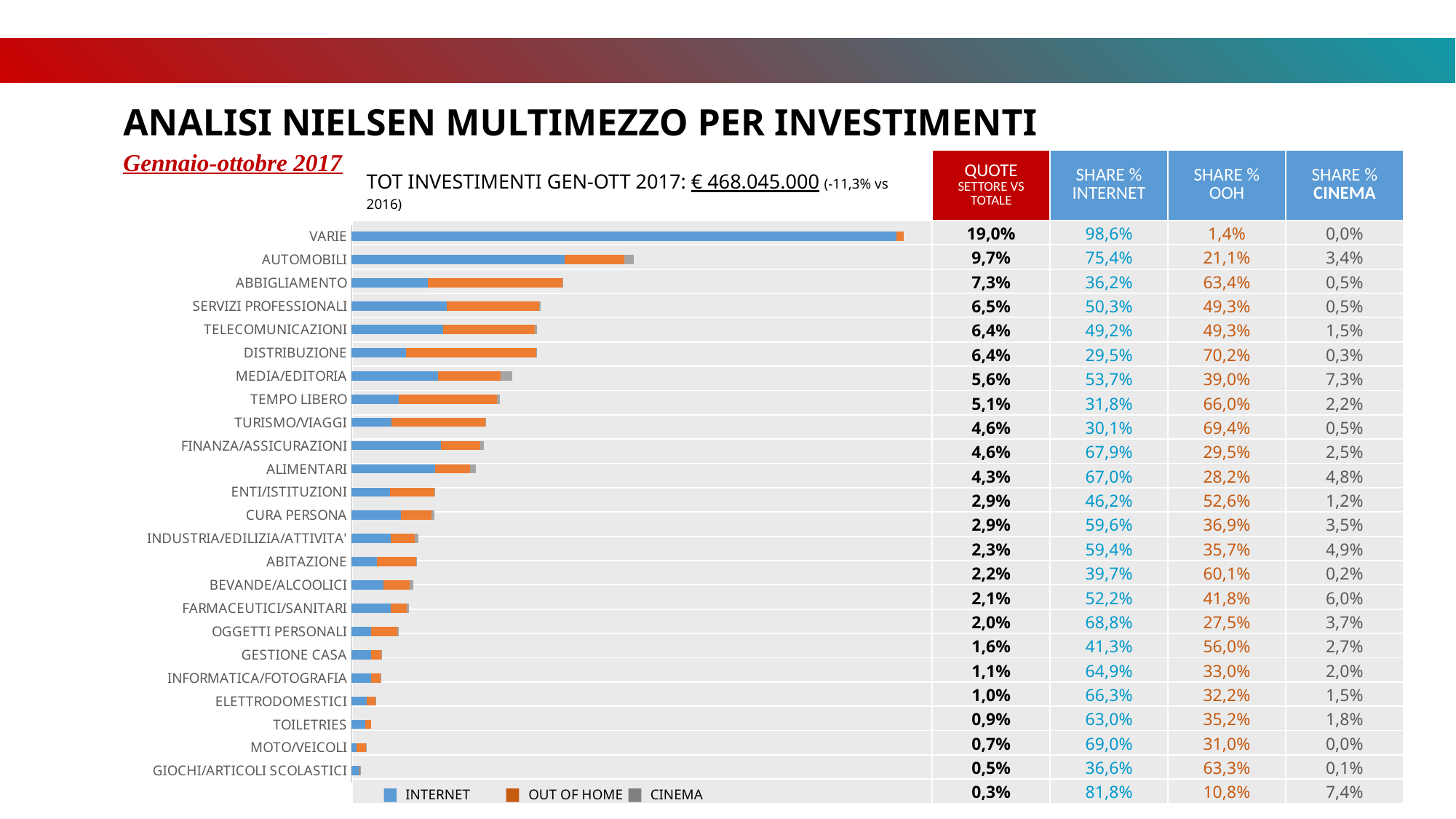
Which category has the longest bar in the chart? VARIE Which colour represents the CINEMA series in the chart? grey In the ABBIGLIAMENTO bar, which segment is larger, INTERNET or OUT OF HOME? OUT OF HOME What are the three series named in the chart legend? INTERNET, OUT OF HOME, CINEMA In the VARIE bar, which series makes up almost the entire bar? INTERNET Which category has the shortest bar in the chart? GIOCHI/ARTICOLI SCOLASTICI Do the bar lengths increase or decrease going from the top category to the bottom category? decrease How many series does the chart legend list? 3 How many categories (sectors) are plotted in the chart? 24 What kind of chart is shown on the slide? stacked bar chart Which bar is longer, TEMPO LIBERO or GESTIONE CASA? TEMPO LIBERO